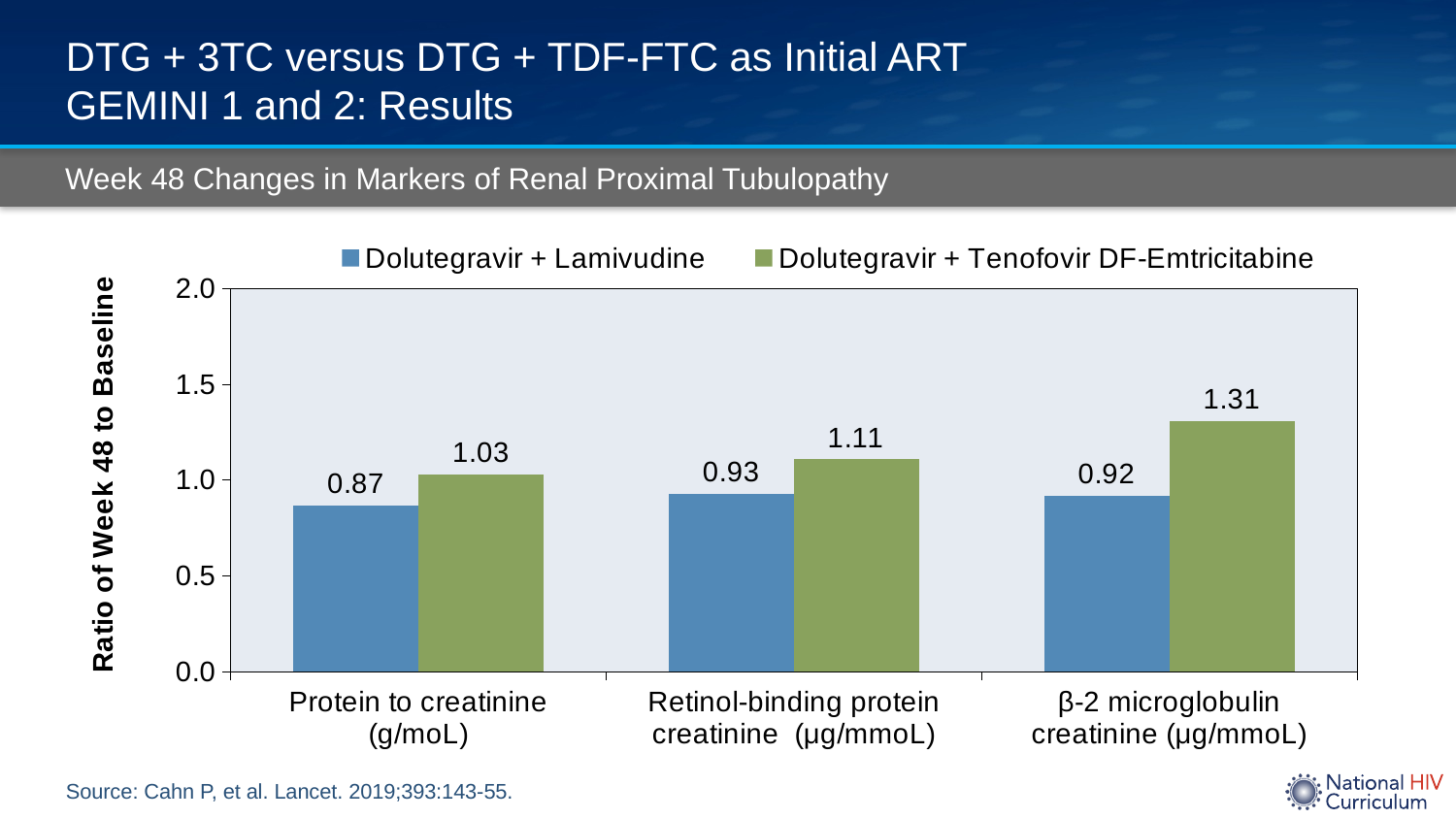
What is the ratio of Week 48 to baseline for Protein to creatinine in the Dolutegravir + Lamivudine group? 0.87 What kind of chart is shown on the slide? Bar chart What is the difference between the two groups' ratios for Retinol-binding protein creatinine? 0.18 How many marker categories are shown on the x axis? 3 What is the ratio of Week 48 to baseline for Retinol-binding protein creatinine in the Dolutegravir + Lamivudine group? 0.93 For Protein to creatinine, which group has the larger ratio? Dolutegravir + Tenofovir DF-Emtricitabine How many series does the legend list? 2 Is the Dolutegravir + Lamivudine value for β-2 microglobulin creatinine greater or less than 1.0? less Which marker has the highest ratio in the Dolutegravir + Tenofovir DF-Emtricitabine group? β-2 microglobulin creatinine What is the difference between the two groups' ratios for β-2 microglobulin creatinine? 0.39 Which marker has the lowest ratio in the Dolutegravir + Lamivudine group? Protein to creatinine What is the ratio of Week 48 to baseline for β-2 microglobulin creatinine in the Dolutegravir + Tenofovir DF-Emtricitabine group? 1.31